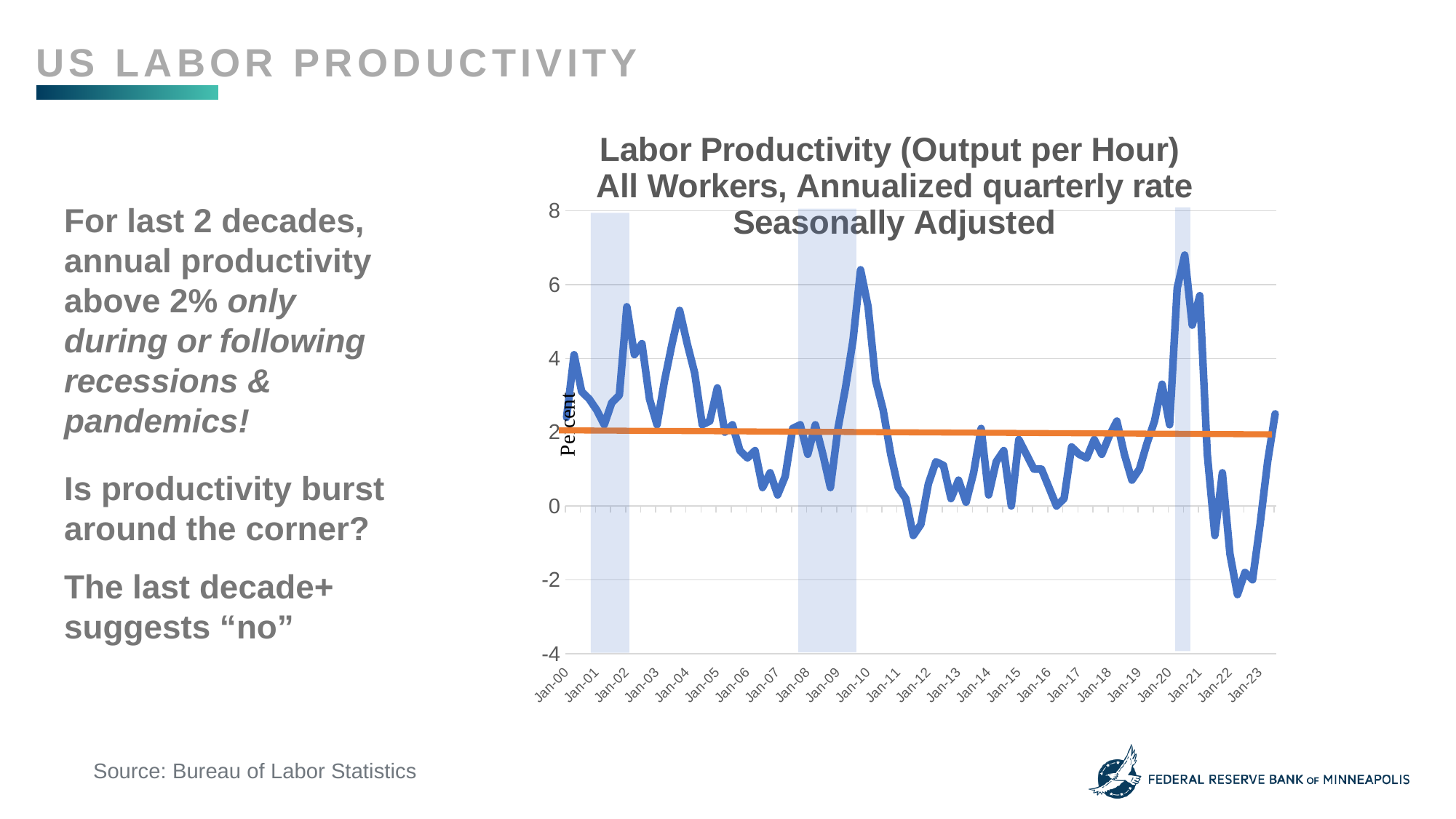
How many year labels are shown along the x axis of the chart? 24 Is the peak of the blue line around Jan-10 greater or less than 6? greater What is the highest value shown on the vertical axis of the chart? 8 Is the value of the blue line at Jan-00 greater or less than 2? greater Is the highest value of the blue line, reached around Jan-20, greater or less than 6? greater What is the label on the vertical axis of the chart? Percent What is the title of the chart? Labor Productivity (Output per Hour) All Workers, Annualized quarterly rate Seasonally Adjusted What kind of chart is shown on the slide? line chart Which is higher: the peak of the blue line around Jan-20 or the peak around Jan-04? the peak around Jan-20